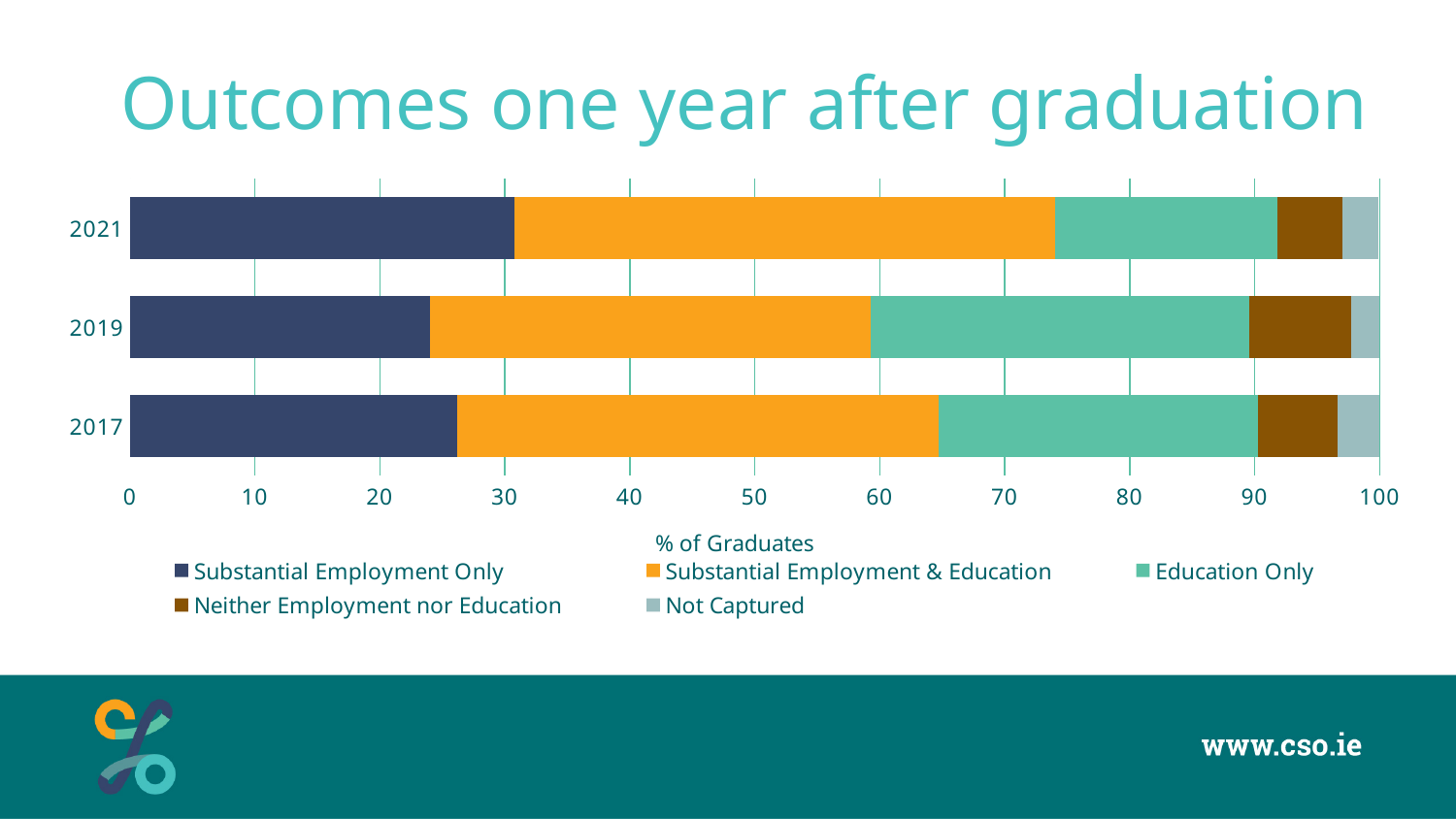
Which year has the smallest Substantial Employment Only share? 2019 How many years (categories) are plotted on the chart? 3 How many series does the legend list? 5 Which year has the largest Education Only share? 2019 What kind of chart is shown on the slide? Stacked bar chart Is the Substantial Employment Only share for 2019 greater or less than 30? less Which is larger: the Education Only share in 2019 or in 2021? 2019 What is the title of the chart? Outcomes one year after graduation Which is larger: the Substantial Employment Only share in 2021 or in 2017? 2021 Is the Substantial Employment Only share for 2021 greater or less than 20? greater What is the label on the horizontal axis? % of Graduates Which year has the largest Substantial Employment Only share? 2021